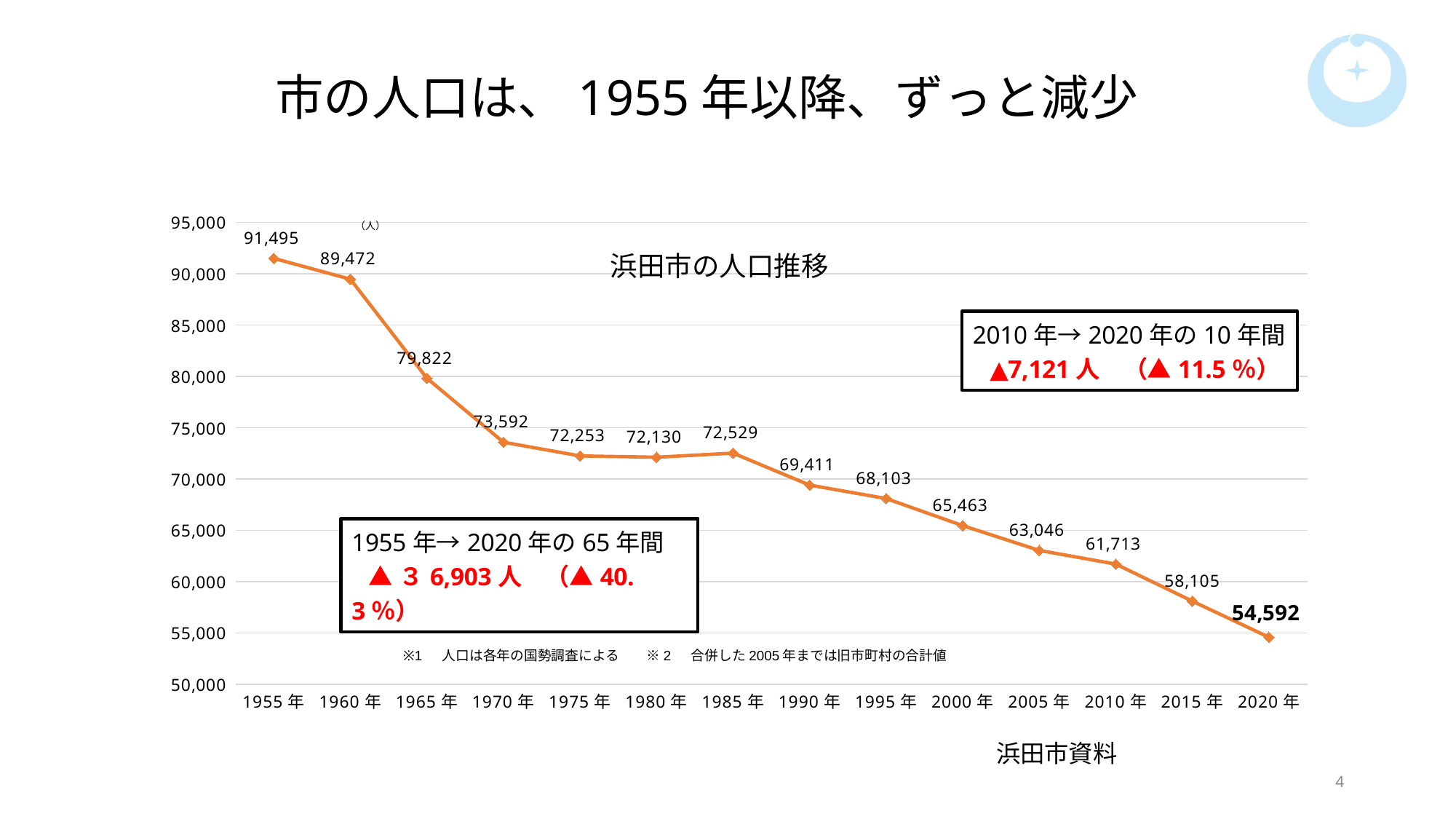
What is the population value for 1955年? 91,495 What is the difference between the population in 2010年 and 2020年? 7,121 Which year has the lowest population value? 2020年 What type of chart is shown on the slide? line chart Which year has the highest population value? 1955年 Which is larger, the population in 1980年 or in 1985年? 1985年 Does the population generally rise or fall from 1955年 to 2020年? fall What is the population value for 1985年? 72,529 What is the population value for 2020年? 54,592 Is the value for 2005年 greater or less than 65,000? less How many data points are plotted on the chart? 14 What is the title of the chart? 浜田市の人口推移